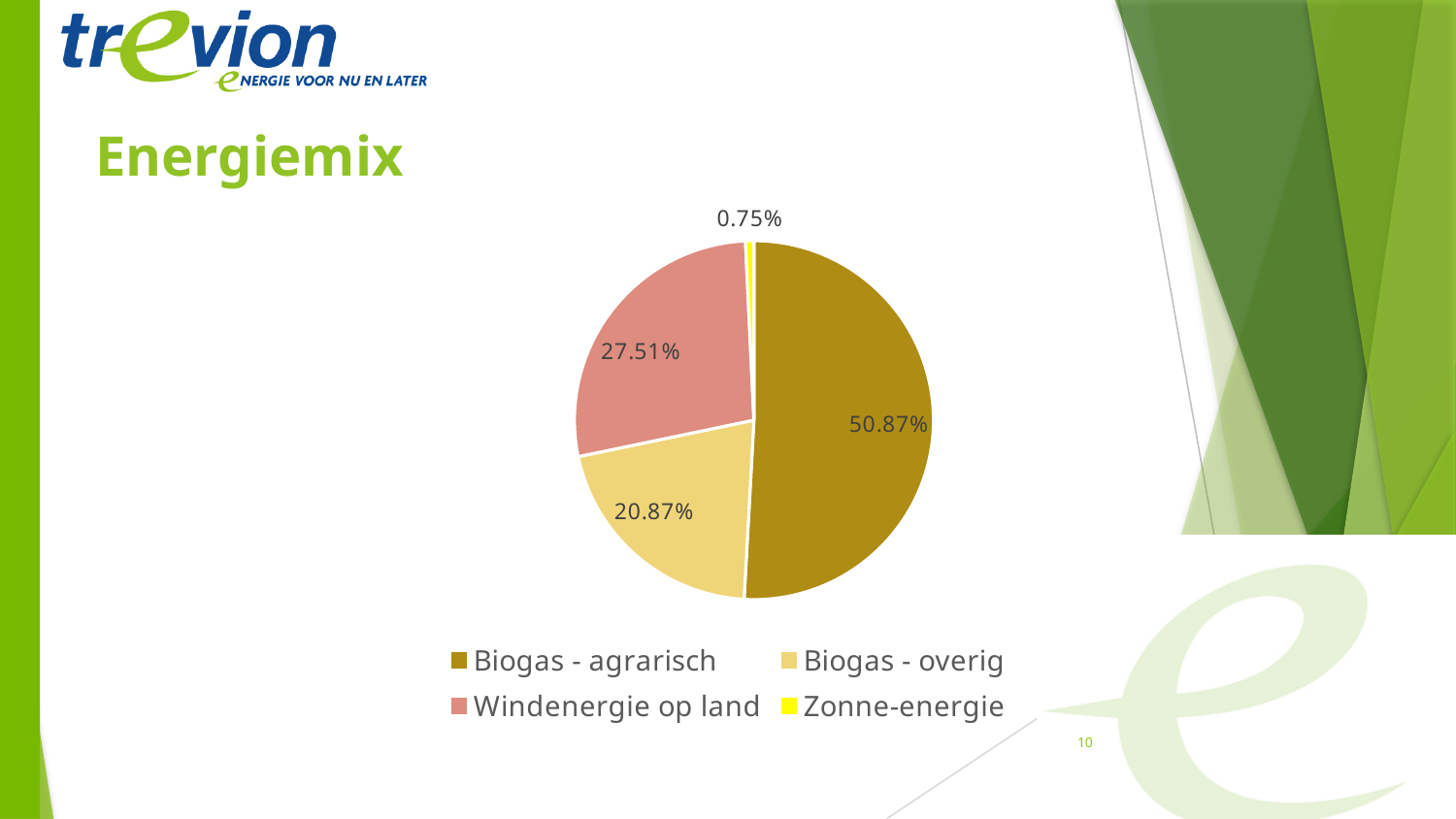
Which category has the largest slice of the pie? Biogas - agrarisch Which is larger, the share for Windenergie op land or the share for Biogas - overig? Windenergie op land How many categories does the pie chart show? 4 What share of the pie does Zonne-energie have? 0.75% What share of the pie does Windenergie op land have? 27.51% What is the difference in percentage points between Biogas - agrarisch and Windenergie op land? 23.36 What kind of chart is shown on the slide? pie chart What share of the pie does Biogas - agrarisch have? 50.87% What is the combined share of Biogas - agrarisch and Biogas - overig? 71.74% Which legend entry is shown in yellow? Zonne-energie What share of the pie does Biogas - overig have? 20.87% Which category has the smallest slice of the pie? Zonne-energie